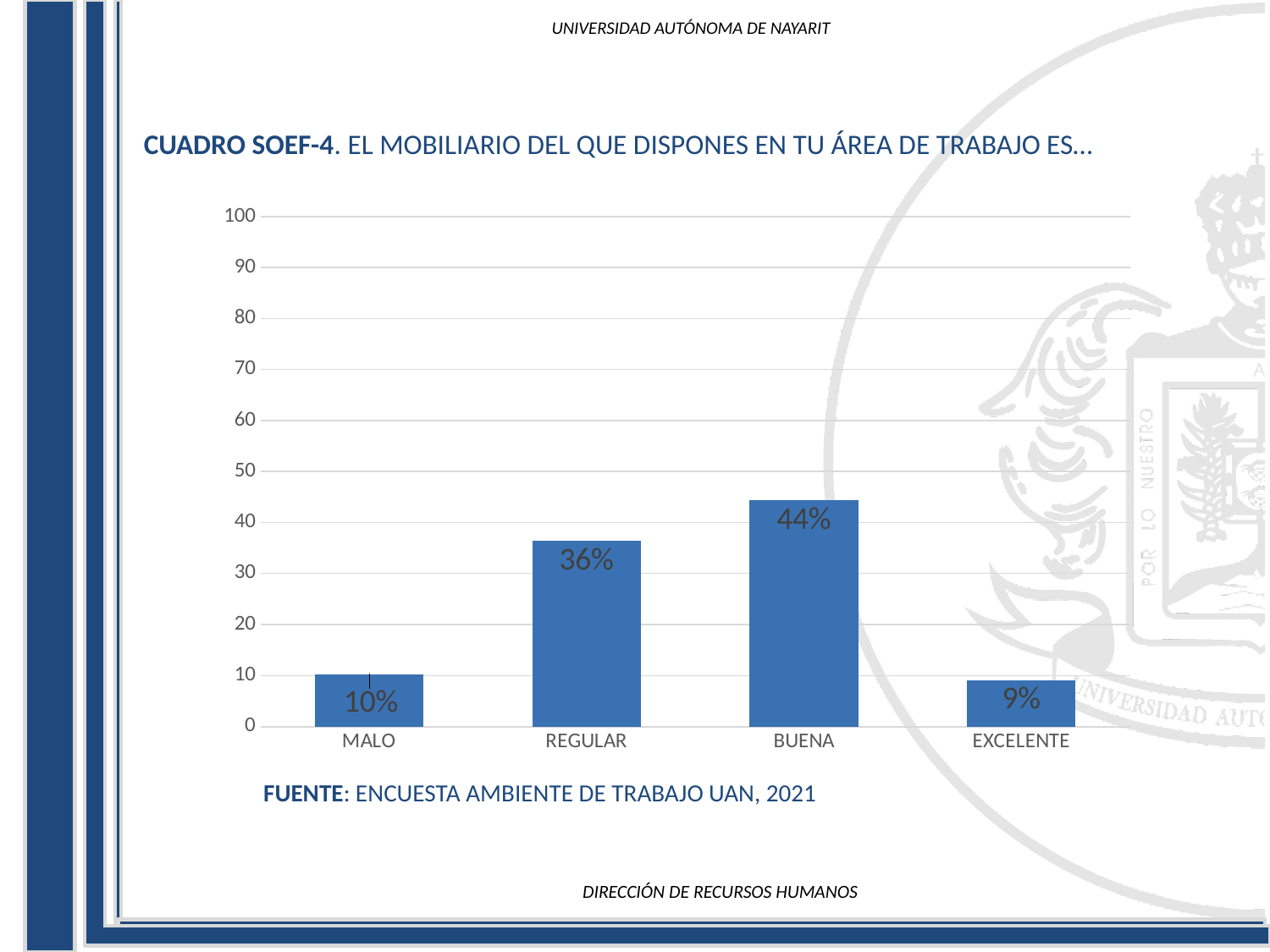
What is the difference between the values for MALO and EXCELENTE? 1% What kind of chart is shown on the slide? bar chart How many categories are shown on the x axis? 4 What is the difference between the values for BUENA and REGULAR? 8% What is the source cited below the chart? ENCUESTA AMBIENTE DE TRABAJO UAN, 2021 Is the value for REGULAR greater or less than 30? greater Which category has the lowest value? EXCELENTE What is the value for EXCELENTE? 9% What is the value for BUENA? 44% What is the value for MALO? 10% Which is larger, the value for REGULAR or the value for MALO? REGULAR Which category has the highest value? BUENA